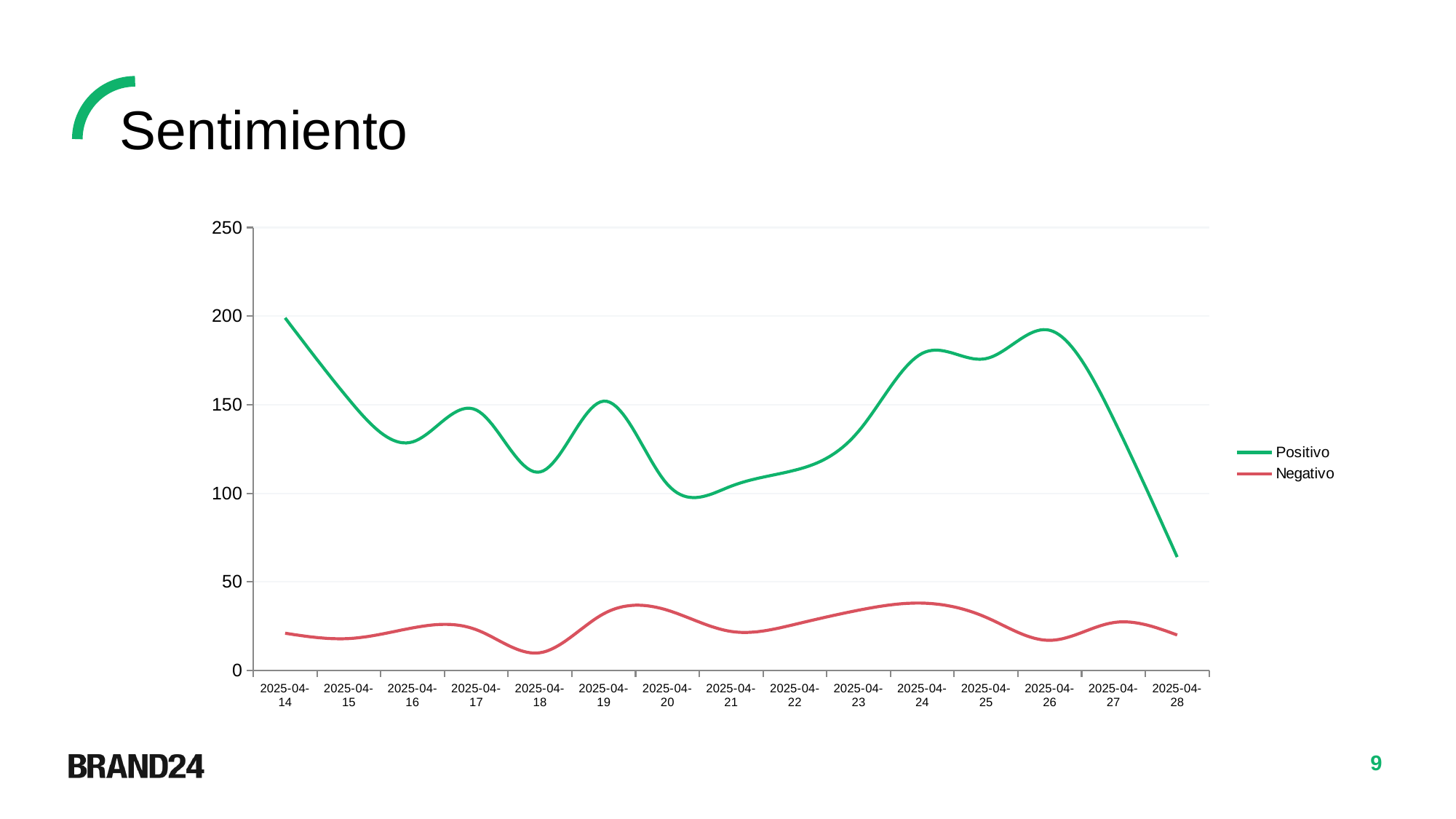
Does the Positivo line rise or fall from 2025-04-26 to 2025-04-28? fall Is the Positivo value for 2025-04-14 greater or less than 150? greater Which is larger on 2025-04-14, the Positivo value or the Negativo value? Positivo On which date is the Positivo value lowest? 2025-04-28 Is the Negativo value for 2025-04-24 greater or less than 50? less What is the title of the slide containing the chart? Sentimiento How many dates are shown on the x axis? 15 On which date is the Negativo value lowest? 2025-04-18 How many series does the legend list? 2 Is the Positivo value for 2025-04-28 greater or less than 100? less What kind of chart is shown on the slide? line chart Which series is drawn in green? Positivo